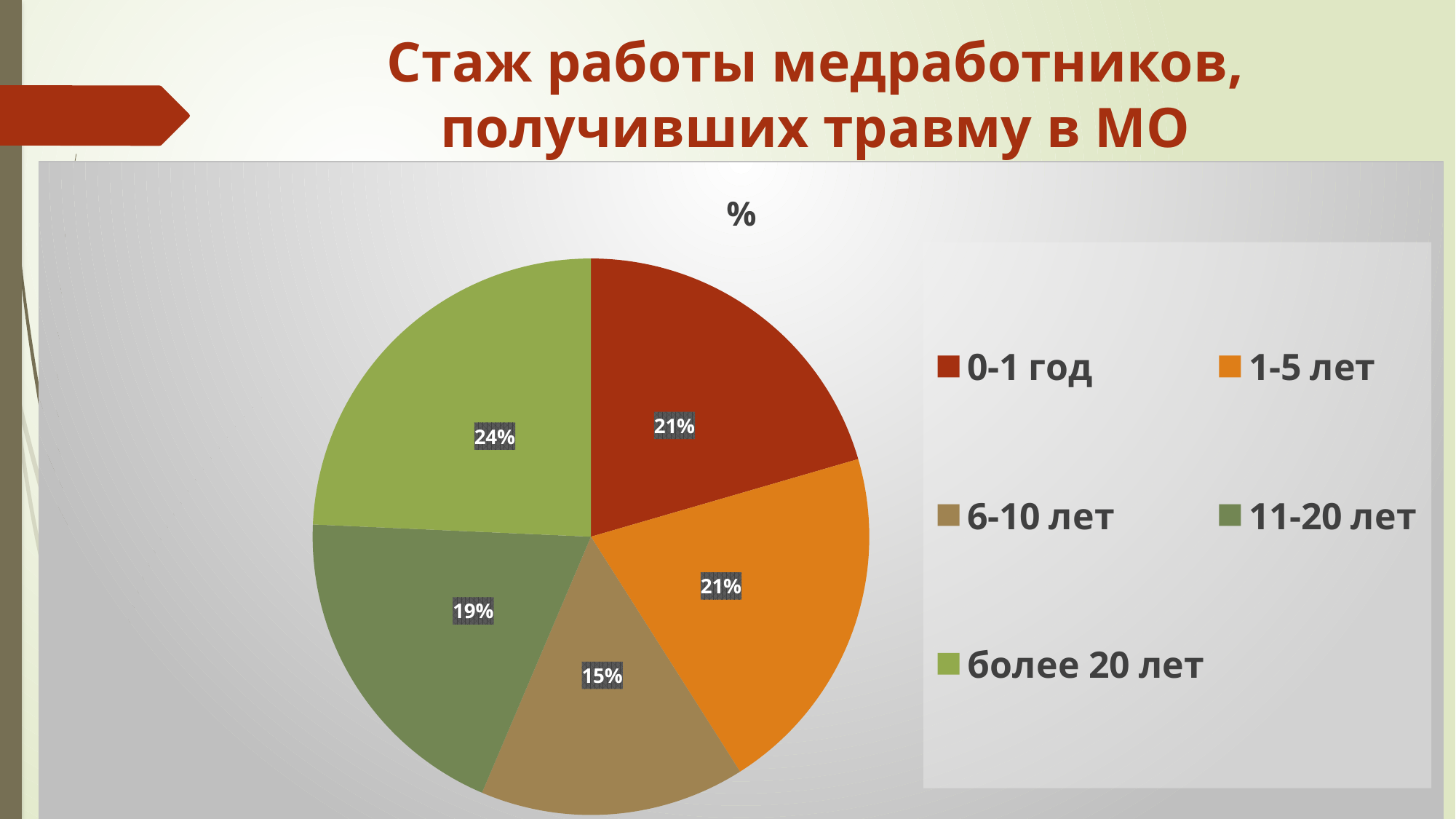
Which category has the largest slice of the pie? более 20 лет What share of the pie does the "0-1 год" slice represent? 21% What is the difference in percentage points between the "более 20 лет" slice and the "6-10 лет" slice? 9 What is the value shown for the "11-20 лет" slice? 19% Which category has the smallest slice of the pie? 6-10 лет What is the title shown above the pie chart? % Which slice is larger: "11-20 лет" or "6-10 лет"? 11-20 лет What type of chart is shown on the slide? pie chart What colour is the "1-5 лет" slice in the pie chart? orange What is the value shown for the "6-10 лет" slice? 15% What share of the pie does the "более 20 лет" slice represent? 24% How many categories are shown in the pie chart? 5